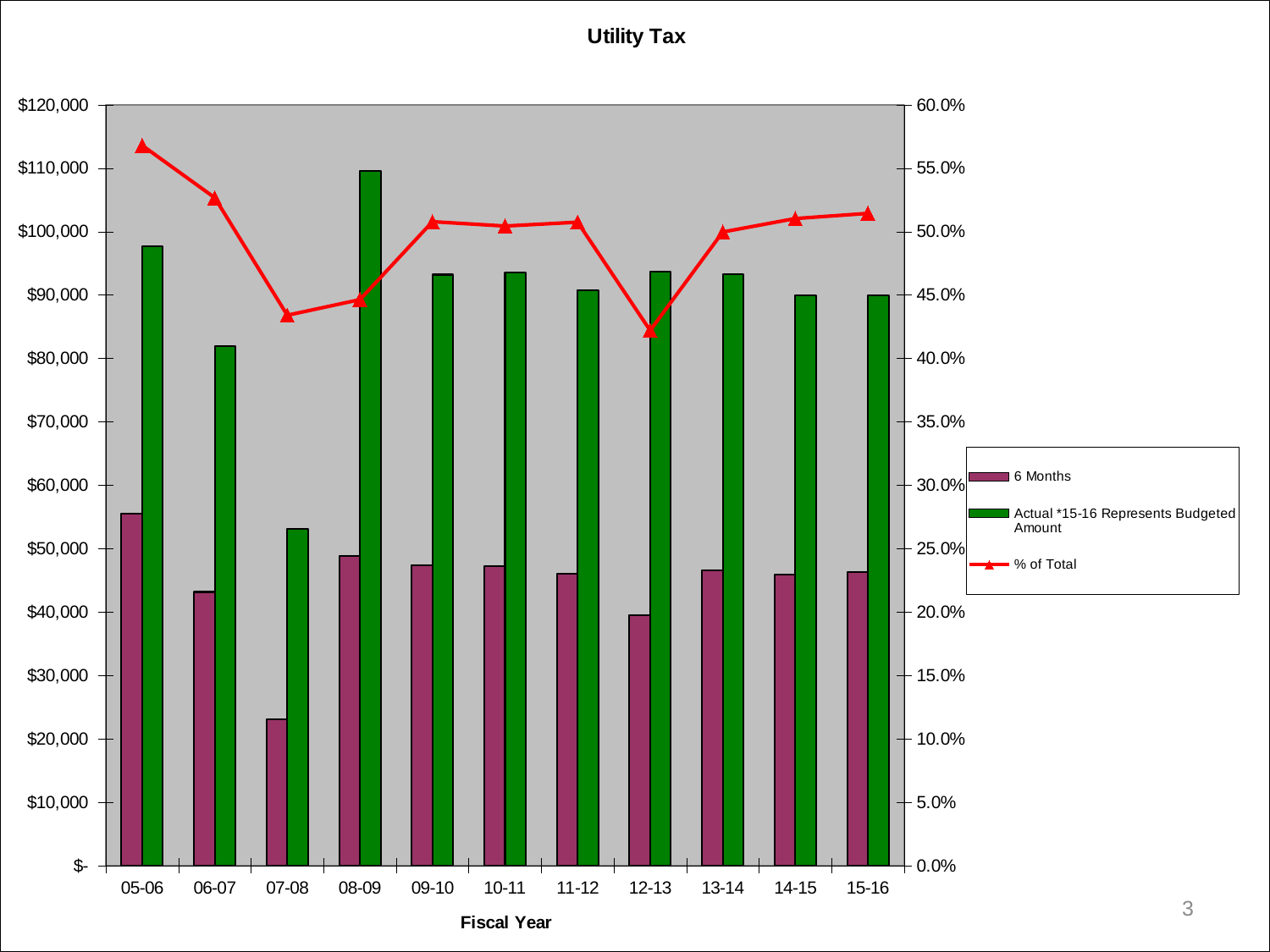
In which fiscal year is the 6 Months bar the lowest? 07-08 What kind of chart is shown on the slide? Combined bar and line chart Is the % of Total value for 12-13 greater or less than 45.0%? less How many series does the legend list? 3 Is the Actual value for 08-09 greater or less than $100,000? greater How many fiscal years are shown on the x axis? 11 Which is larger, the Actual value for 05-06 or the Actual value for 06-07? 05-06 Is the 6 Months value for 07-08 greater or less than $30,000? less What is the title of the chart? Utility Tax In which fiscal year is the % of Total line at its highest point? 05-06 What is the label of the x axis? Fiscal Year In which fiscal year is the Actual bar the highest? 08-09